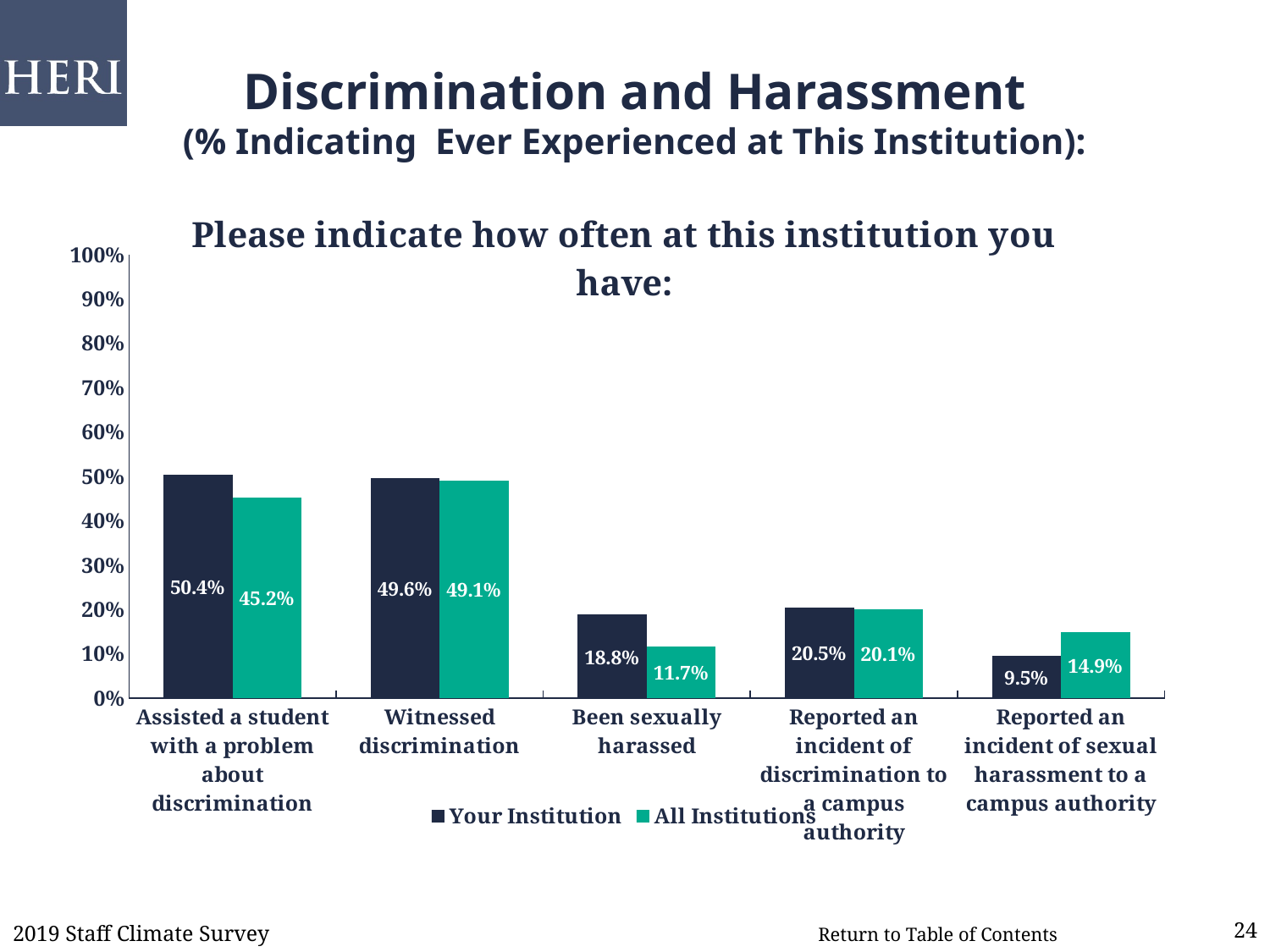
How many categories are shown on the x axis? 5 Is the value for "Your Institution" for "Witnessed discrimination" greater or less than 40%? greater What is the value for "All Institutions" for "Been sexually harassed"? 11.7% What is the difference between "Your Institution" and "All Institutions" for "Been sexually harassed"? 7.1% What are the two series named in the legend? Your Institution and All Institutions What kind of chart is shown on the slide? Bar chart Which category has the highest value for "Your Institution"? Assisted a student with a problem about discrimination What is the value for "Your Institution" for "Reported an incident of sexual harassment to a campus authority"? 9.5% How many series does the legend list? 2 What is the value for "Your Institution" for "Assisted a student with a problem about discrimination"? 50.4% Which category has the lowest value for "All Institutions"? Been sexually harassed For "Reported an incident of sexual harassment to a campus authority", which is larger: "Your Institution" or "All Institutions"? All Institutions